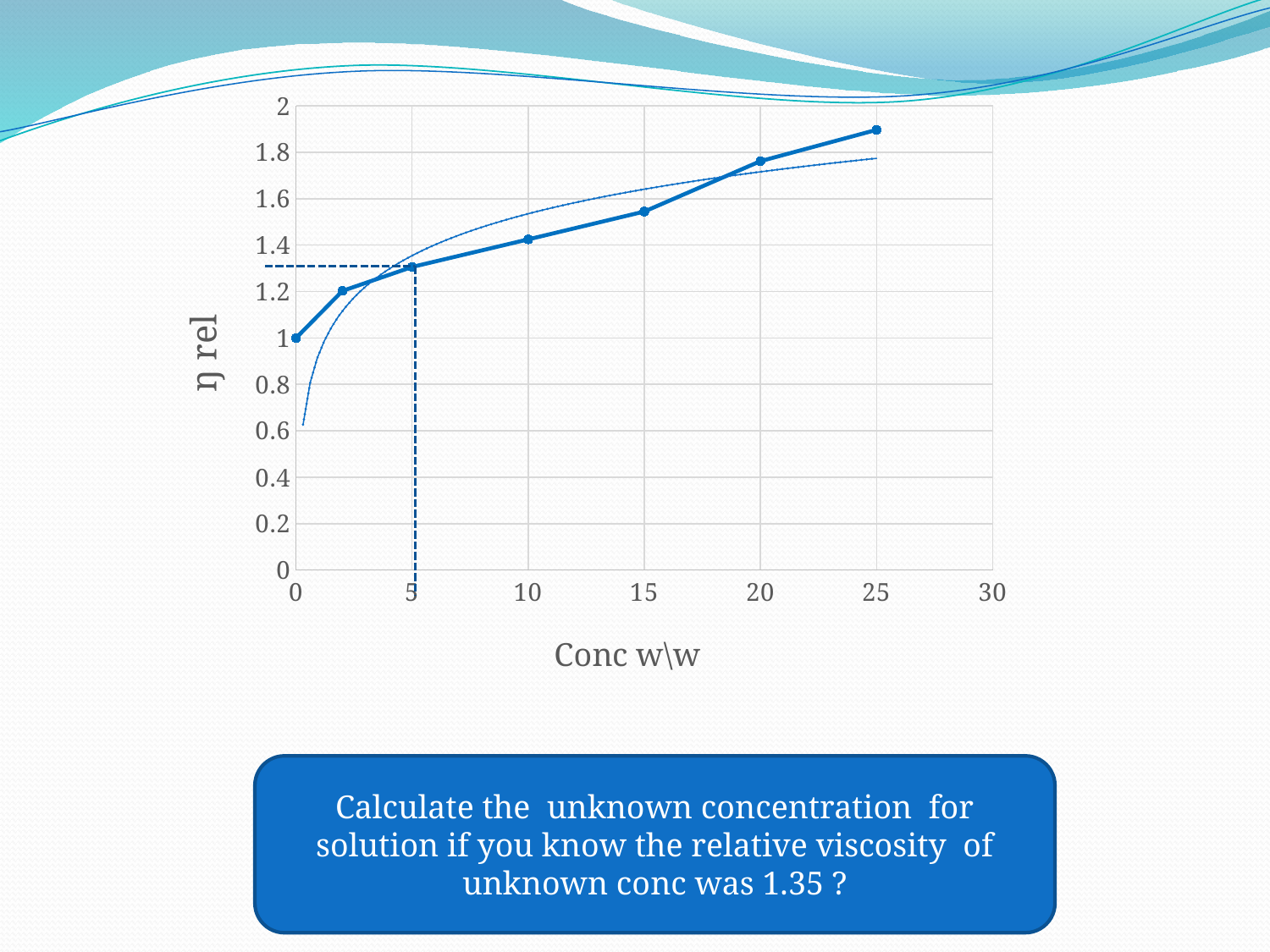
Which has the larger η rel value: concentration 20 or concentration 10? 20 Is the η rel value at a concentration of 25 greater or less than 2? less At which concentration is η rel highest? 25 What is the η rel value at a concentration of 0? 1 Is the η rel value at a concentration of 10 greater or less than 1.4? greater Do the η rel values rise or fall as Conc w\w increases? rise What kind of chart is shown on the slide? line chart Is the η rel value at a concentration of 20 greater or less than 1.8? less What is the title of the x axis? Conc w\w What is the title of the y axis? η rel At which concentration is η rel lowest? 0 How many data points are plotted on the line? 7